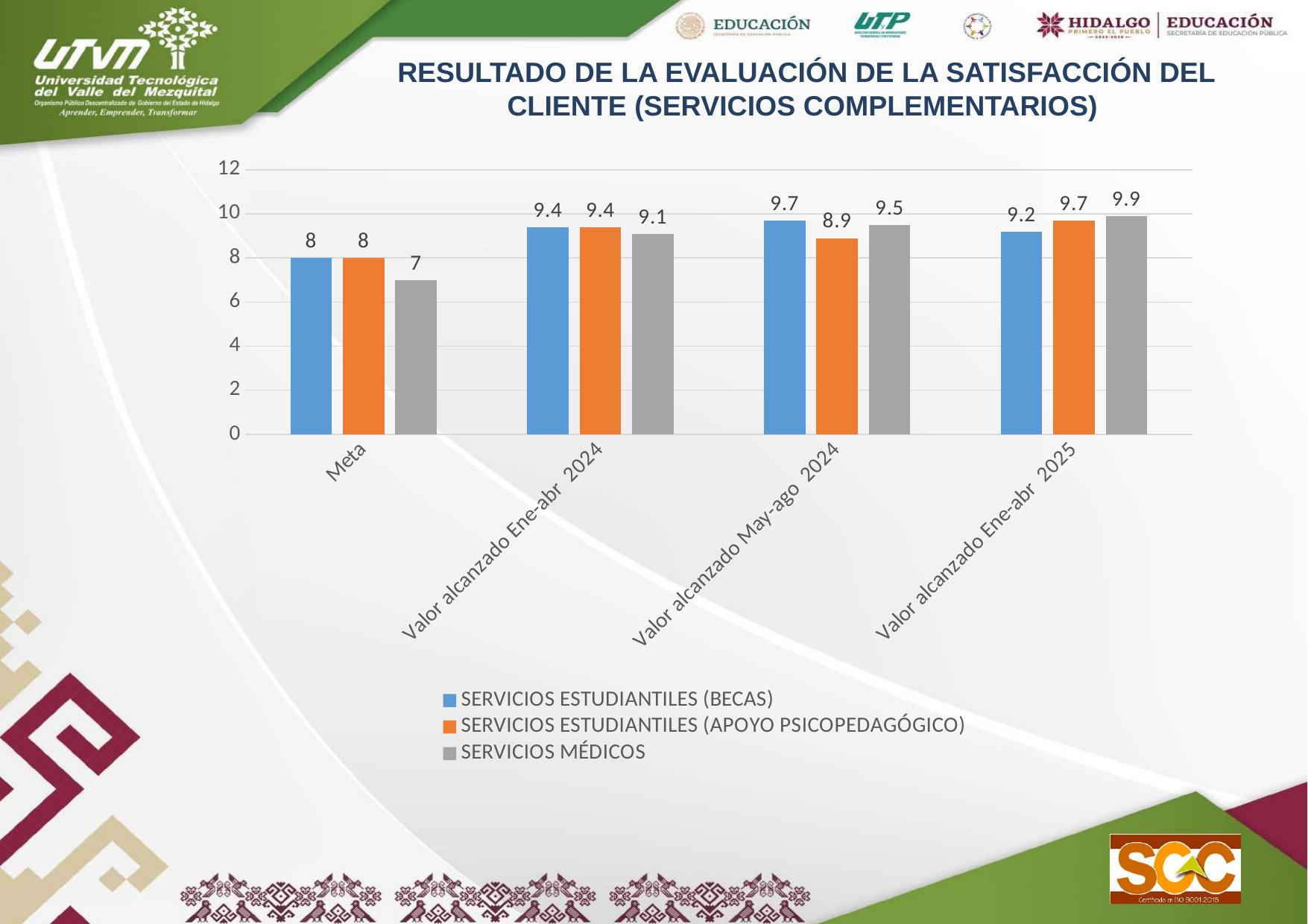
How many categories are shown on the x axis? 4 What kind of chart is shown on the slide? Bar chart Does the SERVICIOS MÉDICOS value rise or fall from Valor alcanzado Ene-abr 2024 to Valor alcanzado Ene-abr 2025? Rise What is the value for SERVICIOS ESTUDIANTILES (APOYO PSICOPEDAGÓGICO) in Valor alcanzado May-ago 2024? 8.9 How many series does the legend list? 3 What is the value for SERVICIOS ESTUDIANTILES (BECAS) in Valor alcanzado Ene-abr 2025? 9.2 Which is larger: SERVICIOS ESTUDIANTILES (BECAS) in Valor alcanzado May-ago 2024 or in Valor alcanzado Ene-abr 2025? Valor alcanzado May-ago 2024 What is the value for SERVICIOS MÉDICOS in the Meta category? 7 What is the difference between the SERVICIOS MÉDICOS value in Valor alcanzado Ene-abr 2025 and its Meta value? 2.9 Which series has the highest value in Valor alcanzado Ene-abr 2025? SERVICIOS MÉDICOS Which colour represents SERVICIOS ESTUDIANTILES (APOYO PSICOPEDAGÓGICO) in the chart? Orange Which series has the lowest value in Valor alcanzado May-ago 2024? SERVICIOS ESTUDIANTILES (APOYO PSICOPEDAGÓGICO)